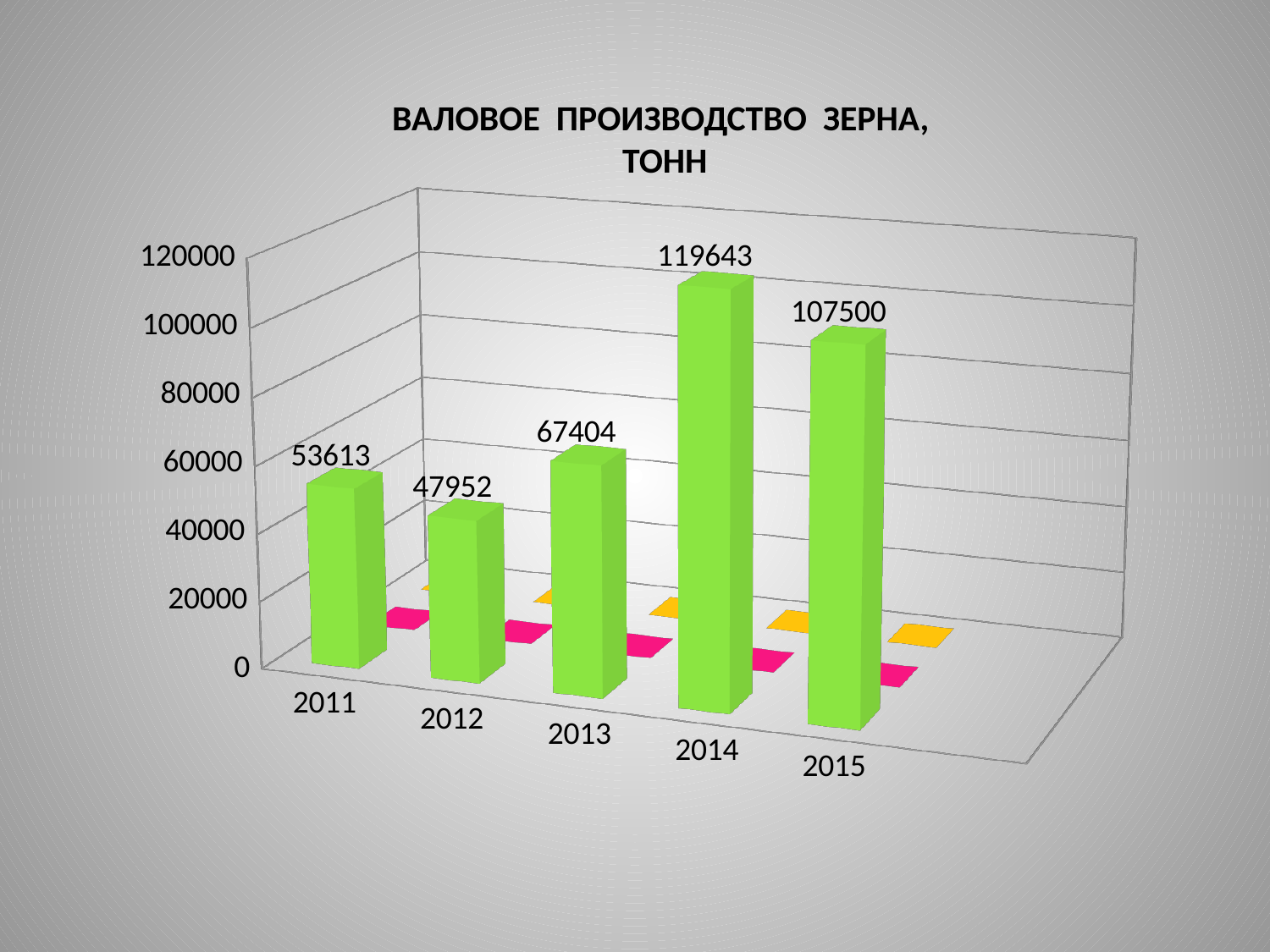
What is the difference between the values for 2014 and 2015? 12143 Which is larger, the value for 2011 or the value for 2013? 2013 What is the value for 2011? 53613 Which year has the highest value? 2014 How many years are shown on the x axis? 5 What is the title of the chart? ВАЛОВОЕ ПРОИЗВОДСТВО ЗЕРНА, ТОНН Is the value for 2015 greater or less than 100000? greater What kind of chart is this? bar chart What is the value for 2015? 107500 Which year has the lowest value? 2012 What is the value for 2014? 119643 What is the difference between the values for 2013 and 2012? 9452